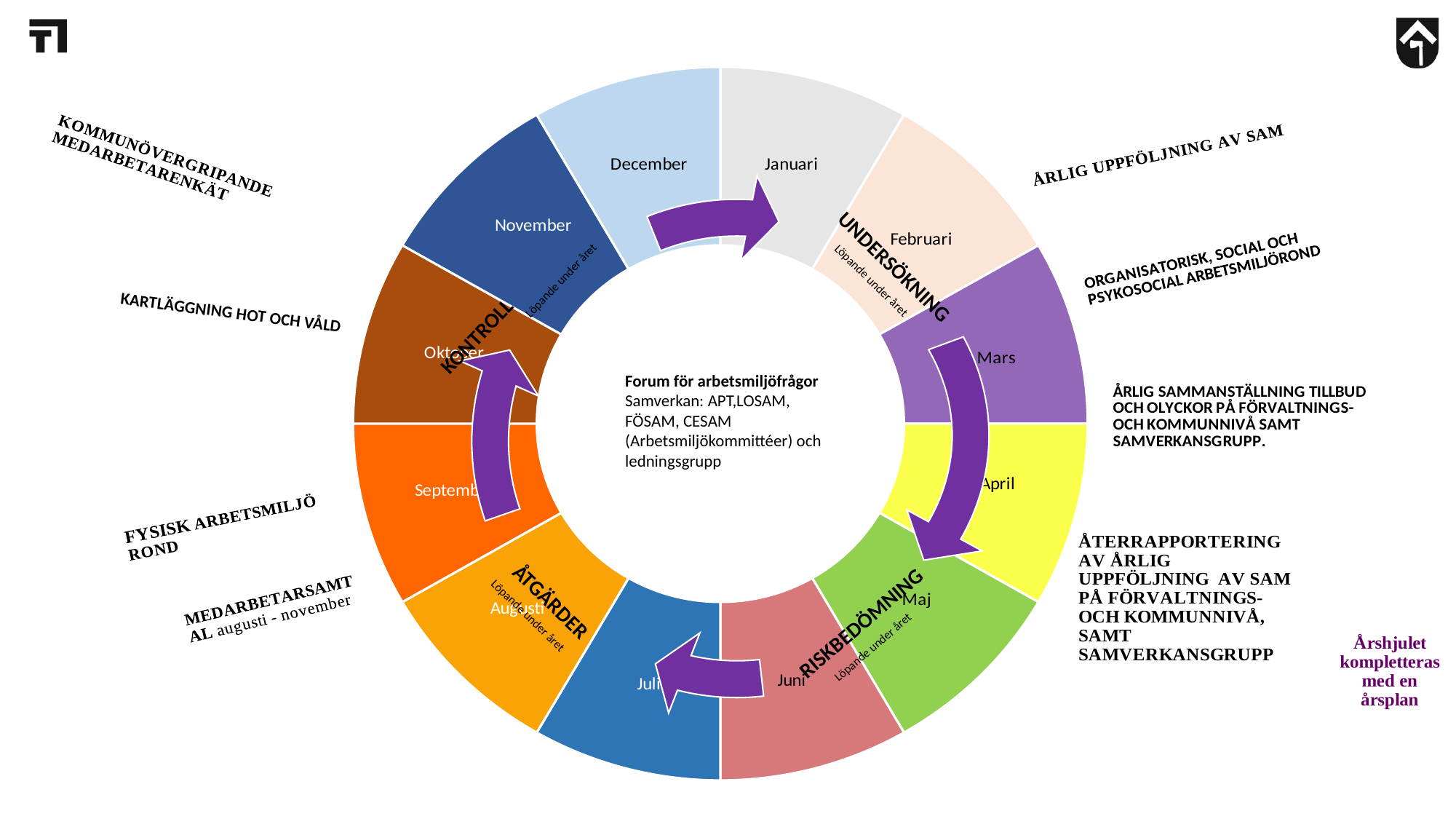
What kind of chart is shown on the slide? Doughnut chart Which month segment sits between Januari and Mars in the ring chart? Februari What is the bold heading of the text in the centre of the ring chart? Forum för arbetsmiljöfrågor Which month label appears in the yellow segment of the ring chart? April How many segments does the ring chart have? 12 Which month segment comes directly after Juli going clockwise around the ring chart? Augusti